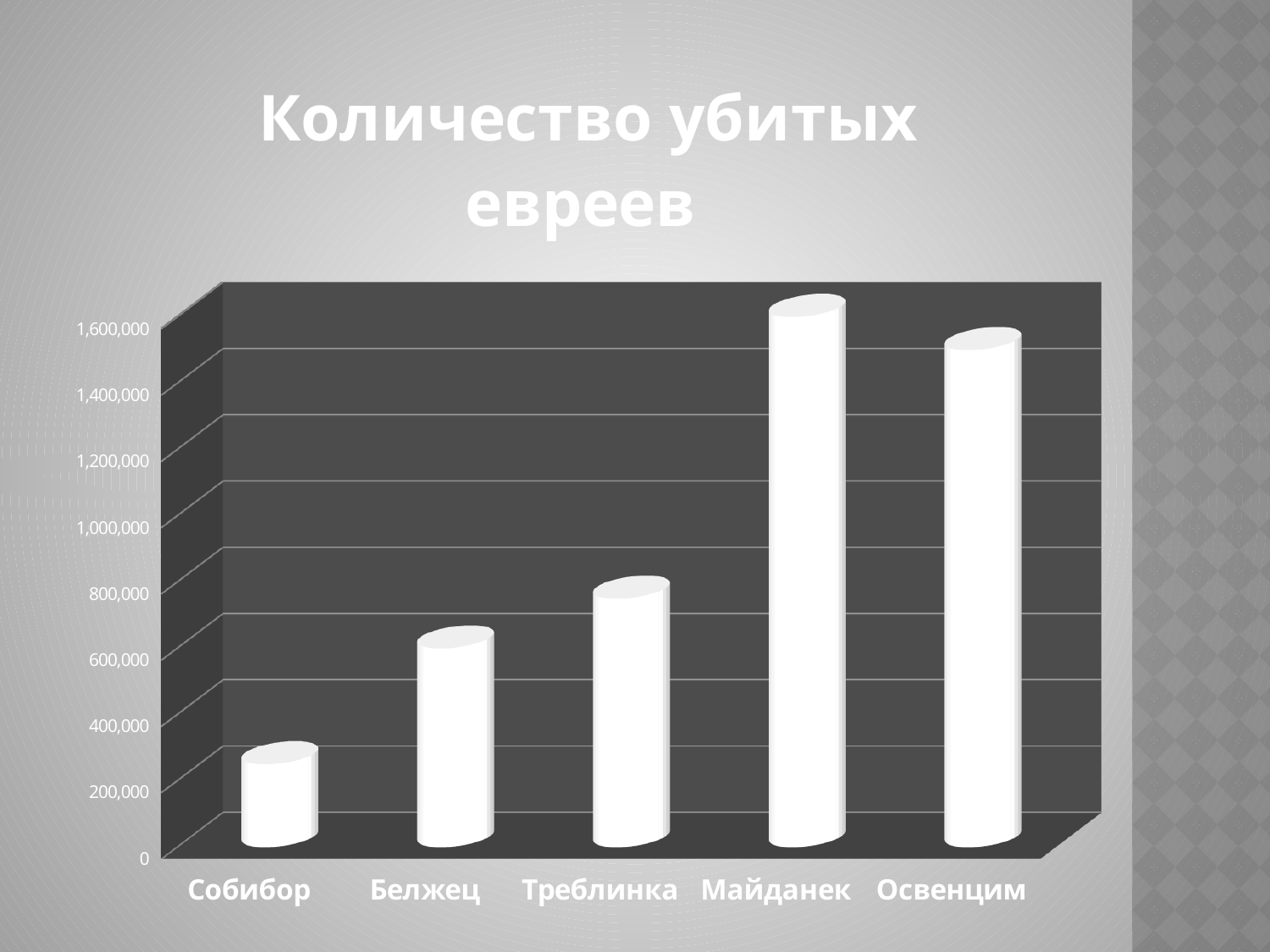
What kind of chart is shown on the slide? bar chart Is the value for Освенцим greater or less than 1,200,000? greater Which category has the highest value? Майданек How many categories are shown on the x axis? 5 What is the title of the chart? Количество убитых евреев Which is larger, the value for Белжец or the value for Треблинка? Треблинка Is the value for Майданек greater or less than 1,000,000? greater Which category has the lowest value? Собибор Is the value for Собибор greater or less than 400,000? less Do the values rise or fall from Собибор to Майданек along the x axis? rise